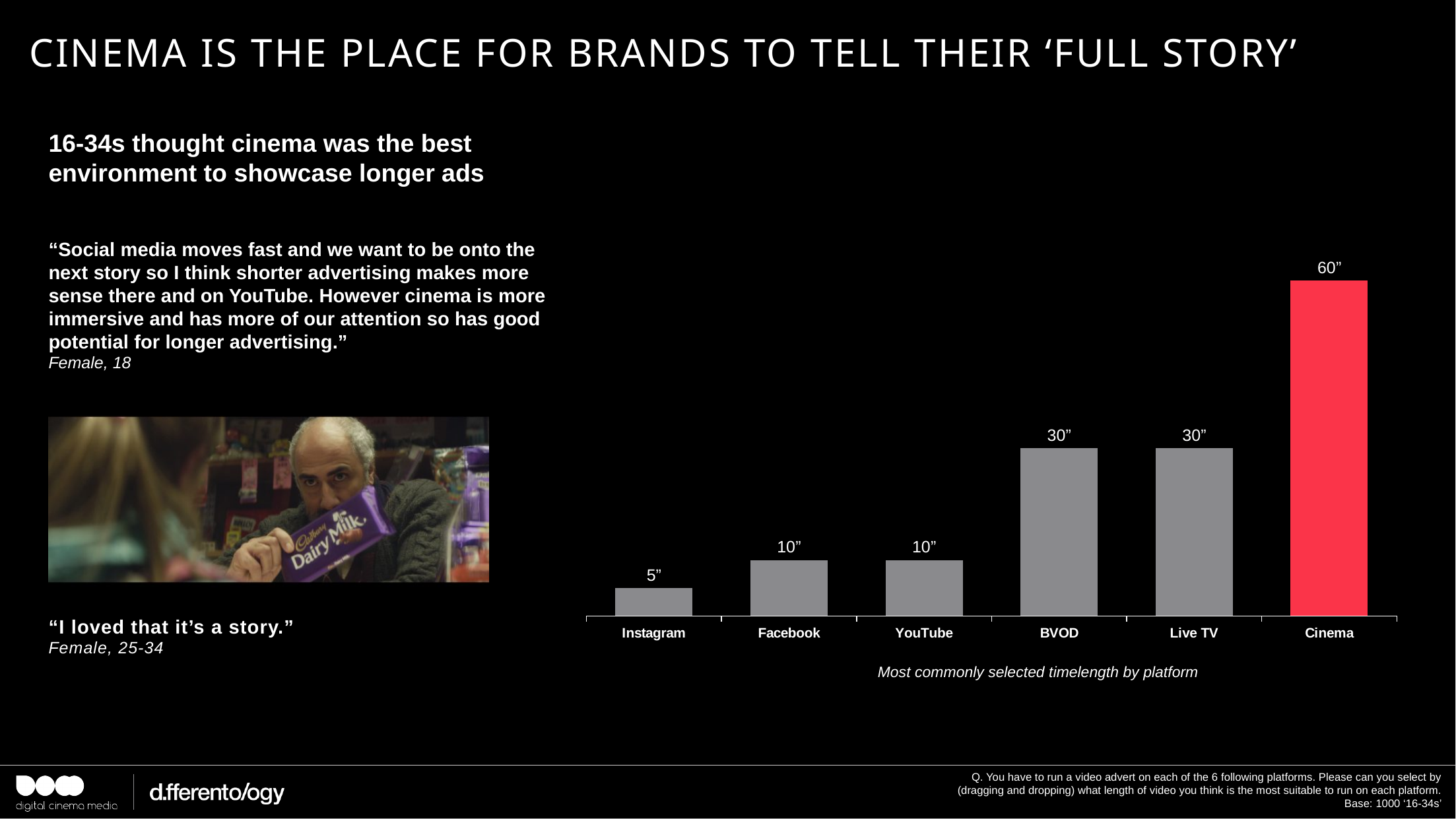
What is the most commonly selected timelength for Facebook? 10” Do the values rise or fall from Instagram to Cinema along the x axis? Rise Which platform has the highest most commonly selected timelength? Cinema Which is larger, the timelength for YouTube or the timelength for BVOD? BVOD What kind of chart is shown on the slide? Bar chart What is the most commonly selected timelength for Instagram? 5” Which platform has the lowest most commonly selected timelength? Instagram What is the most commonly selected timelength for Cinema? 60” What is the most commonly selected timelength for BVOD? 30” What is the difference between the timelength for Cinema and the timelength for Live TV? 30” Which bar in the chart is coloured red rather than grey? Cinema How many platforms are shown in the chart? 6